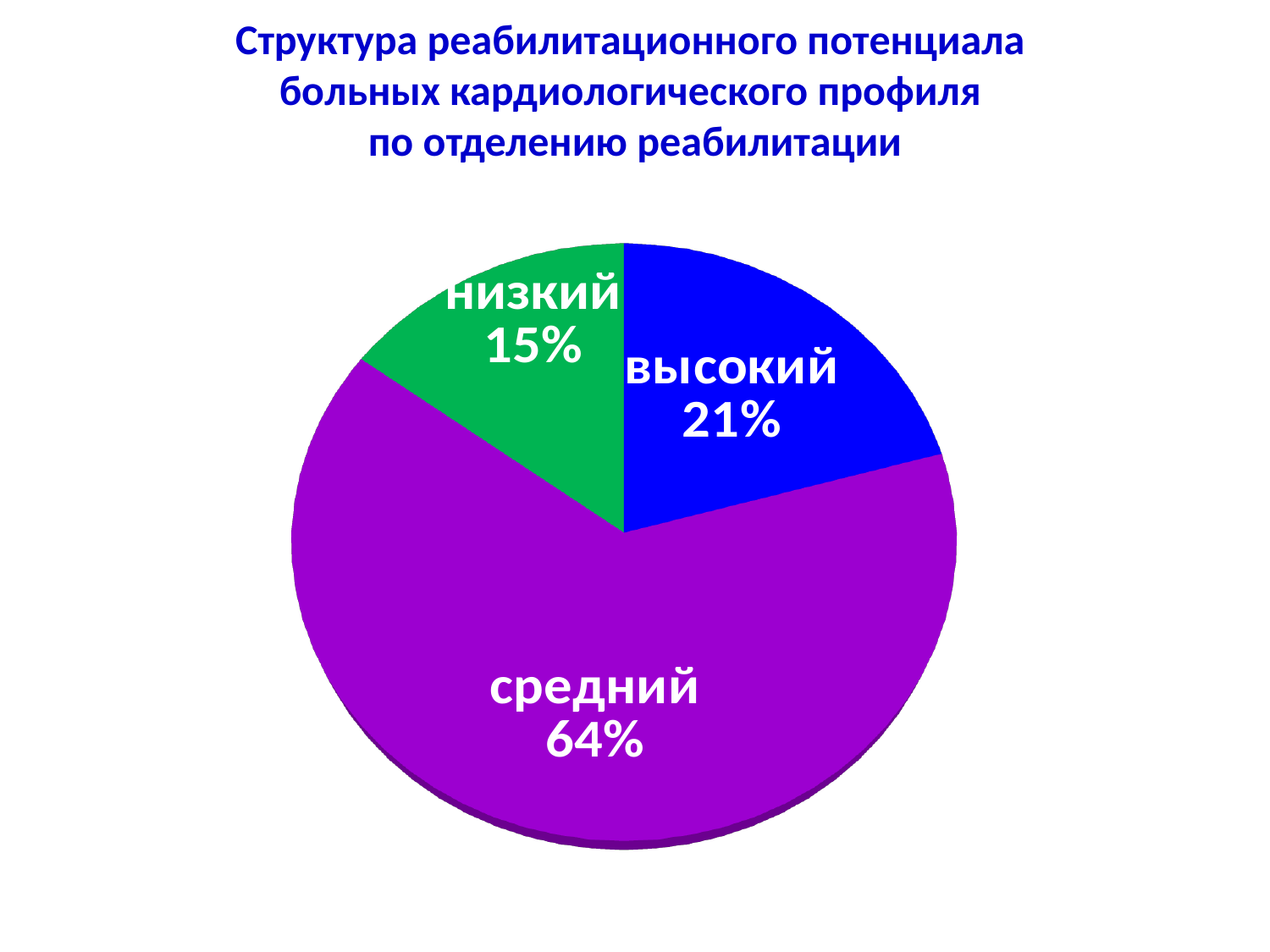
Which category has the smallest slice of the pie? низкий What is the difference in percentage points between the "высокий" and "низкий" slices? 6 What share of the pie does the "высокий" slice represent? 21% Which category has the largest slice of the pie? средний What colour is the "средний" slice? purple What colour is the "низкий" slice? green What share of the pie does the "низкий" slice represent? 15% Which slice is larger, "высокий" or "низкий"? высокий What share of the pie does the "средний" slice represent? 64% What kind of chart is shown on the slide? pie chart What is the difference in percentage points between the "средний" and "высокий" slices? 43 How many slices does the pie chart have? 3